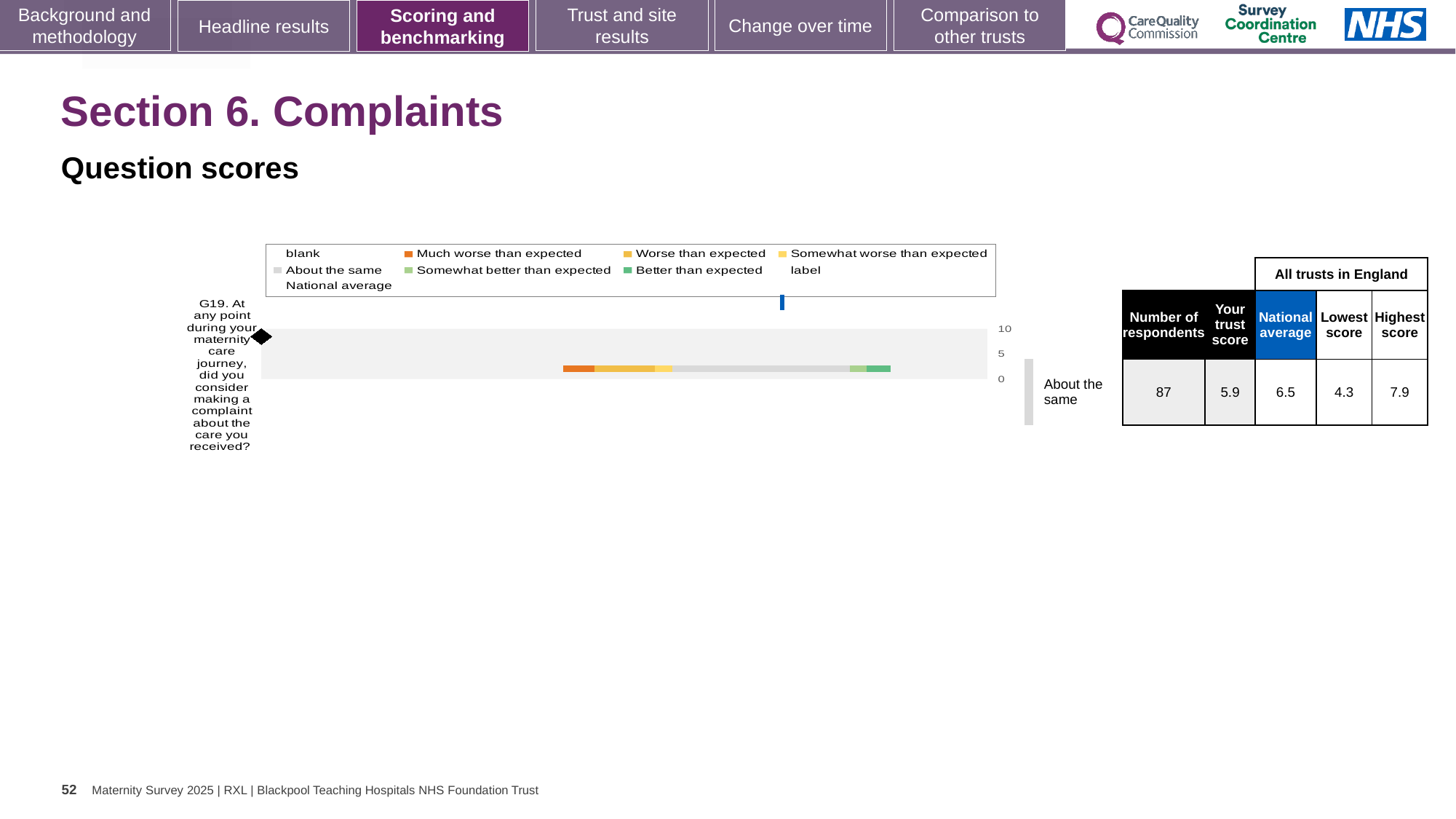
What is the number of respondents for question G19? 87 Which is larger for question G19, the trust's score or the national average? National average What is the difference between the highest and lowest scores among all trusts in England for question G19? 3.6 What kind of chart is shown on the slide for question G19? bar chart What is the highest score among all trusts in England for question G19? 7.9 By how much does the national average exceed the trust's score for question G19? 0.6 What is the trust's score for question G19? 5.9 What is the national average score for question G19? 6.5 Which benchmark category is the trust's result for G19 placed in? About the same What colour represents 'Much worse than expected' in the chart legend? Orange How many survey questions are plotted in the chart? 1 What is the lowest score among all trusts in England for question G19? 4.3